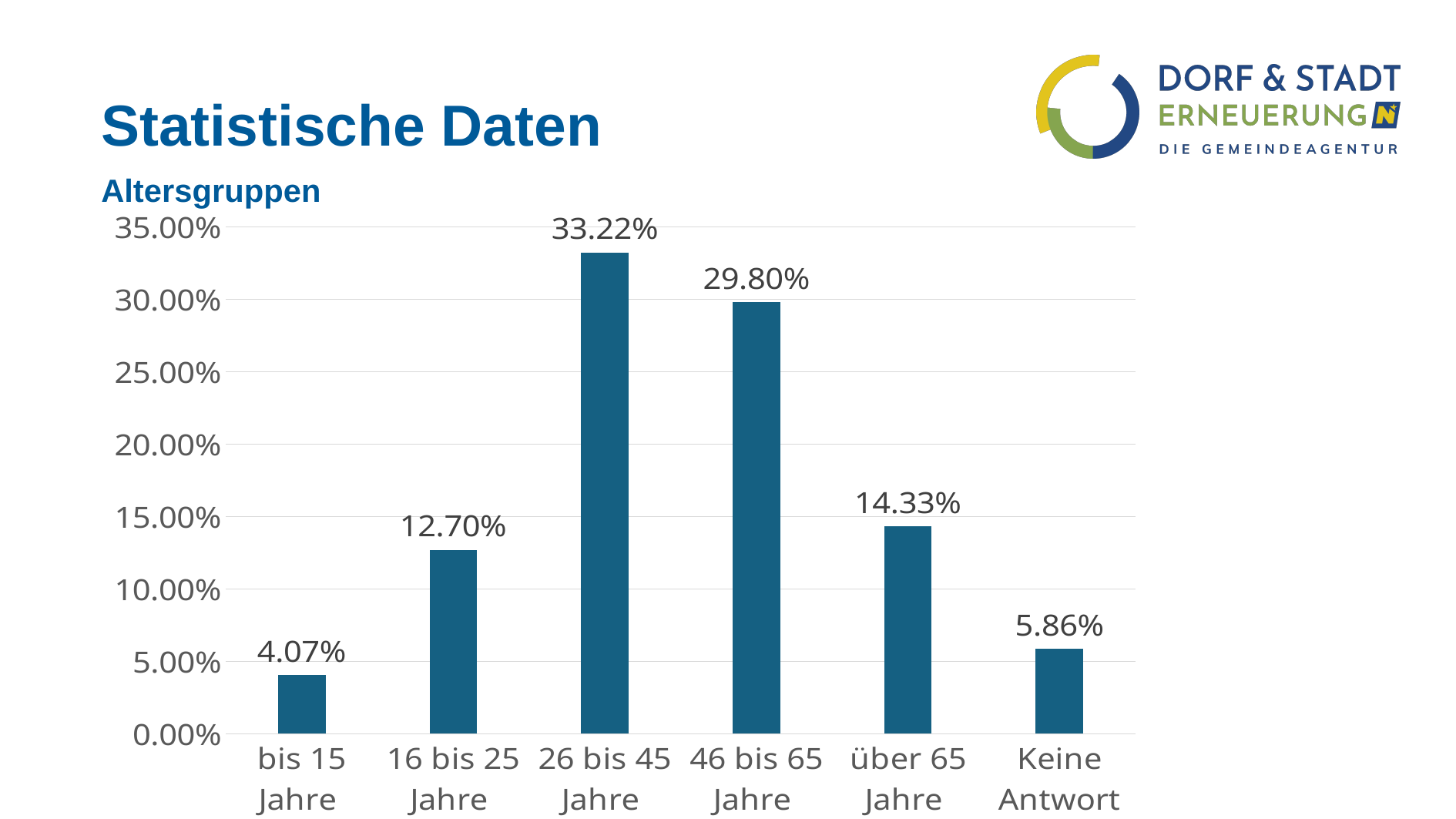
What is the value for 'Keine Antwort'? 5.86% What is the value for the 'über 65 Jahre' age group? 14.33% What is the difference between the values for '26 bis 45 Jahre' and '46 bis 65 Jahre'? 3.42% Which is larger, the value for '16 bis 25 Jahre' or for 'über 65 Jahre'? über 65 Jahre What is the title of the chart? Altersgruppen What kind of chart is shown on the slide? bar chart Which category has the lowest value? bis 15 Jahre How many categories are shown on the x axis? 6 What is the difference between the values for '16 bis 25 Jahre' and 'bis 15 Jahre'? 8.63% Is the value for '46 bis 65 Jahre' greater or less than 25.00%? greater What is the value for the '26 bis 45 Jahre' age group? 33.22% Which age group has the highest value? 26 bis 45 Jahre